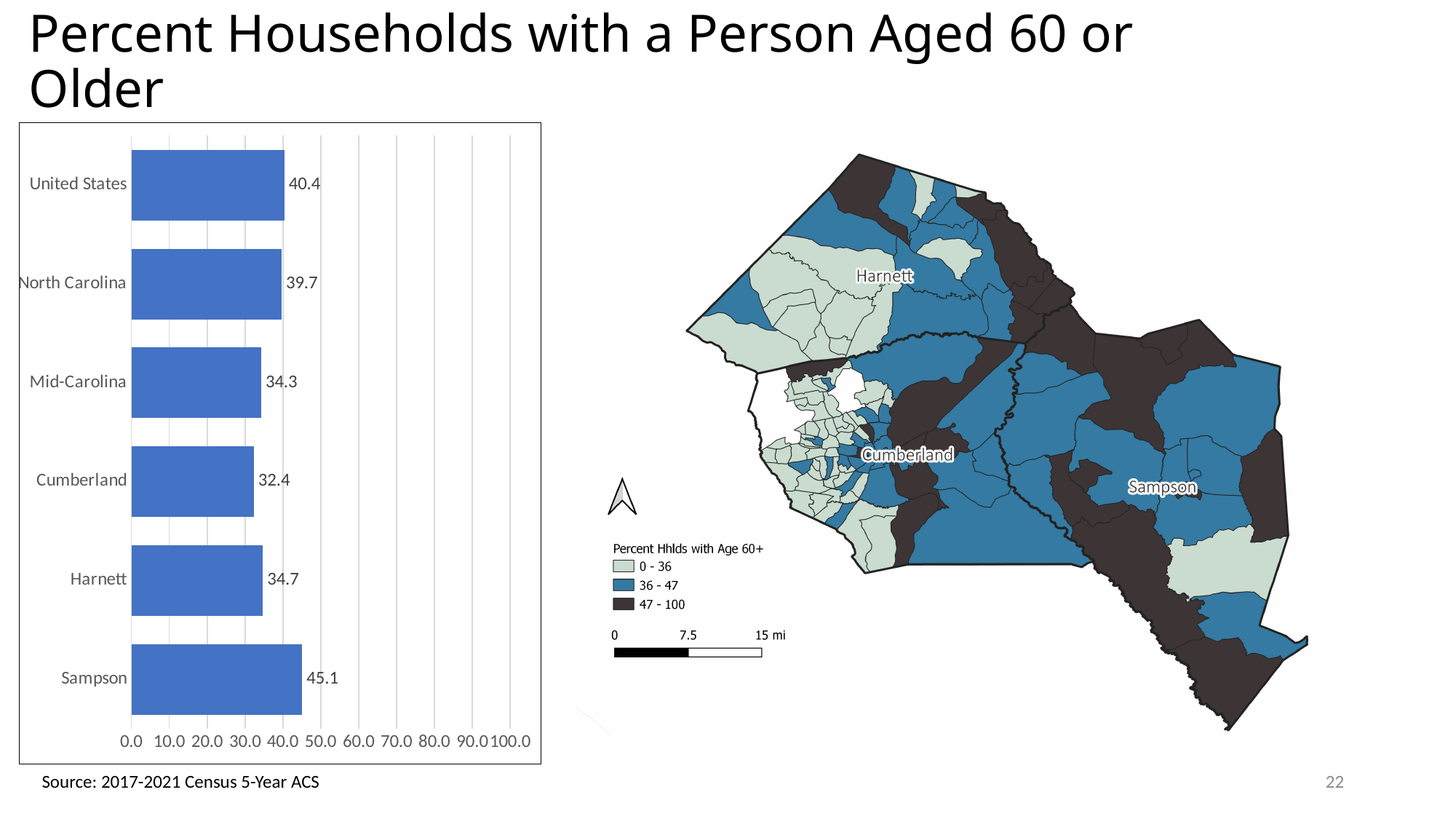
In the bar chart, what is the value for Harnett? 34.7 In the bar chart, is the value for Mid-Carolina greater or less than 40.0? less What kind of chart is shown on the left of the slide? bar chart How many categories are shown in the bar chart? 6 In the bar chart, what is the difference between the values for Sampson and Cumberland? 12.7 In the bar chart, what is the difference between the values for United States and North Carolina? 0.7 In the bar chart, what is the value for Sampson? 45.1 In the bar chart, which category has the lowest value? Cumberland In the bar chart, what is the value for Cumberland? 32.4 In the bar chart, which category has the highest value? Sampson In the bar chart, what is the value for North Carolina? 39.7 In the bar chart, which is larger, the value for Sampson or the value for United States? Sampson